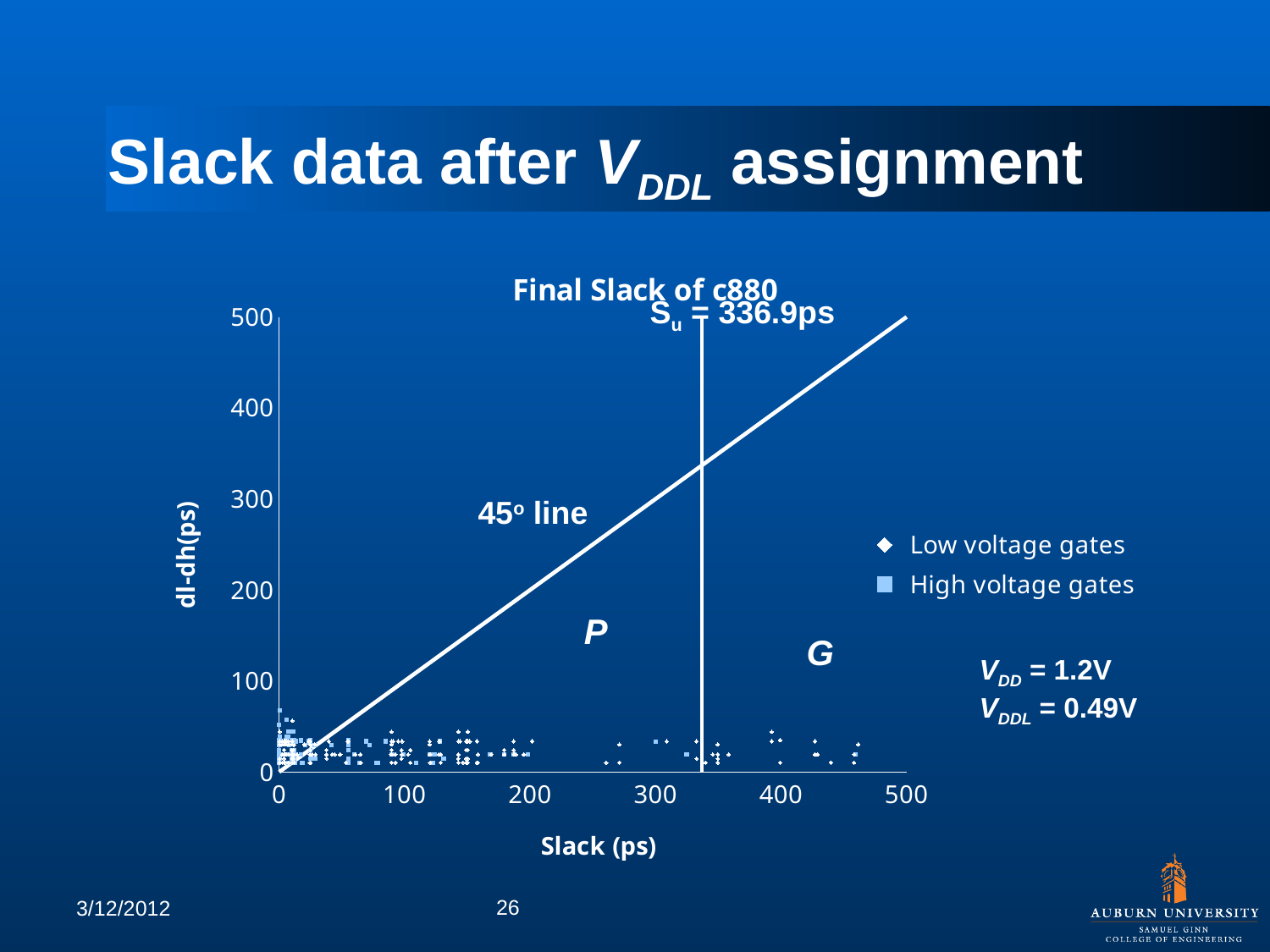
What value of Su is marked by the vertical line on the chart? 336.9ps Are the dl-dh values of the plotted gates greater or less than 100 on the y axis? less What is the title of the chart? Final Slack of c880 What are the two series named in the chart legend? Low voltage gates and High voltage gates What is the label of the y axis of the chart? dl-dh(ps) How many series does the chart's legend list? 2 What is the label of the x axis of the chart? Slack (ps) Which marker shape represents the Low voltage gates series in the legend? diamond What value of VDD is stated next to the chart? 1.2V What value of VDDL is stated next to the chart? 0.49V What is the maximum value shown on the x axis of the chart? 500 What kind of chart is shown on the slide? scatter chart